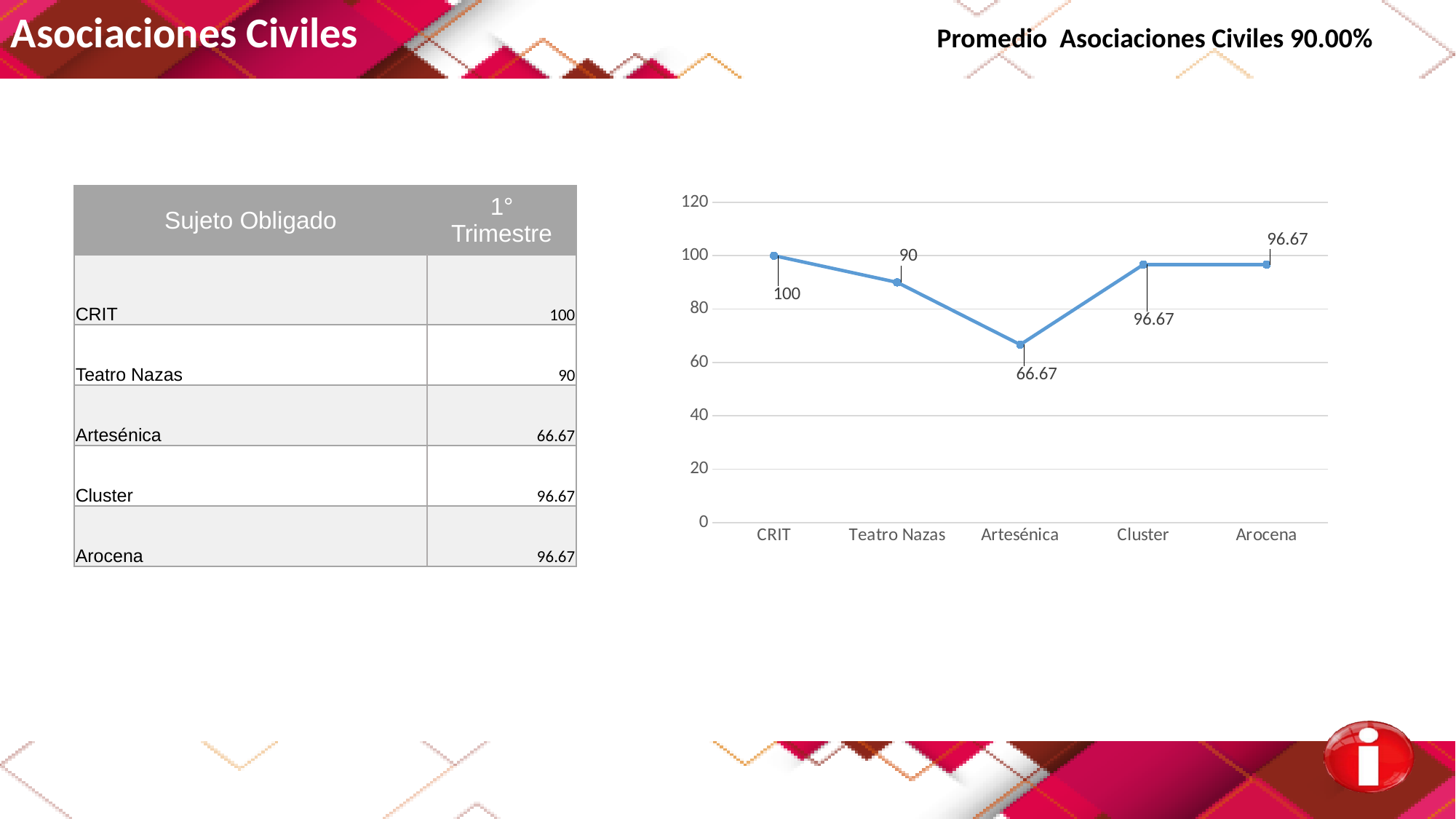
What kind of chart is shown on the slide? line chart Which category has the highest value in the chart? CRIT What is the value plotted for Cluster? 96.67 What is the difference between the values for CRIT and Artesénica? 33.33 Is the value for Artesénica greater or less than 80? less Which category has the lowest value in the chart? Artesénica What is the difference between the values for Teatro Nazas and Cluster? 6.67 What is the value plotted for Artesénica? 66.67 Which is larger, the value for Teatro Nazas or the value for Arocena? Arocena What is the value plotted for CRIT? 100 How many categories are plotted on the x axis of the chart? 5 What is the value plotted for Teatro Nazas? 90